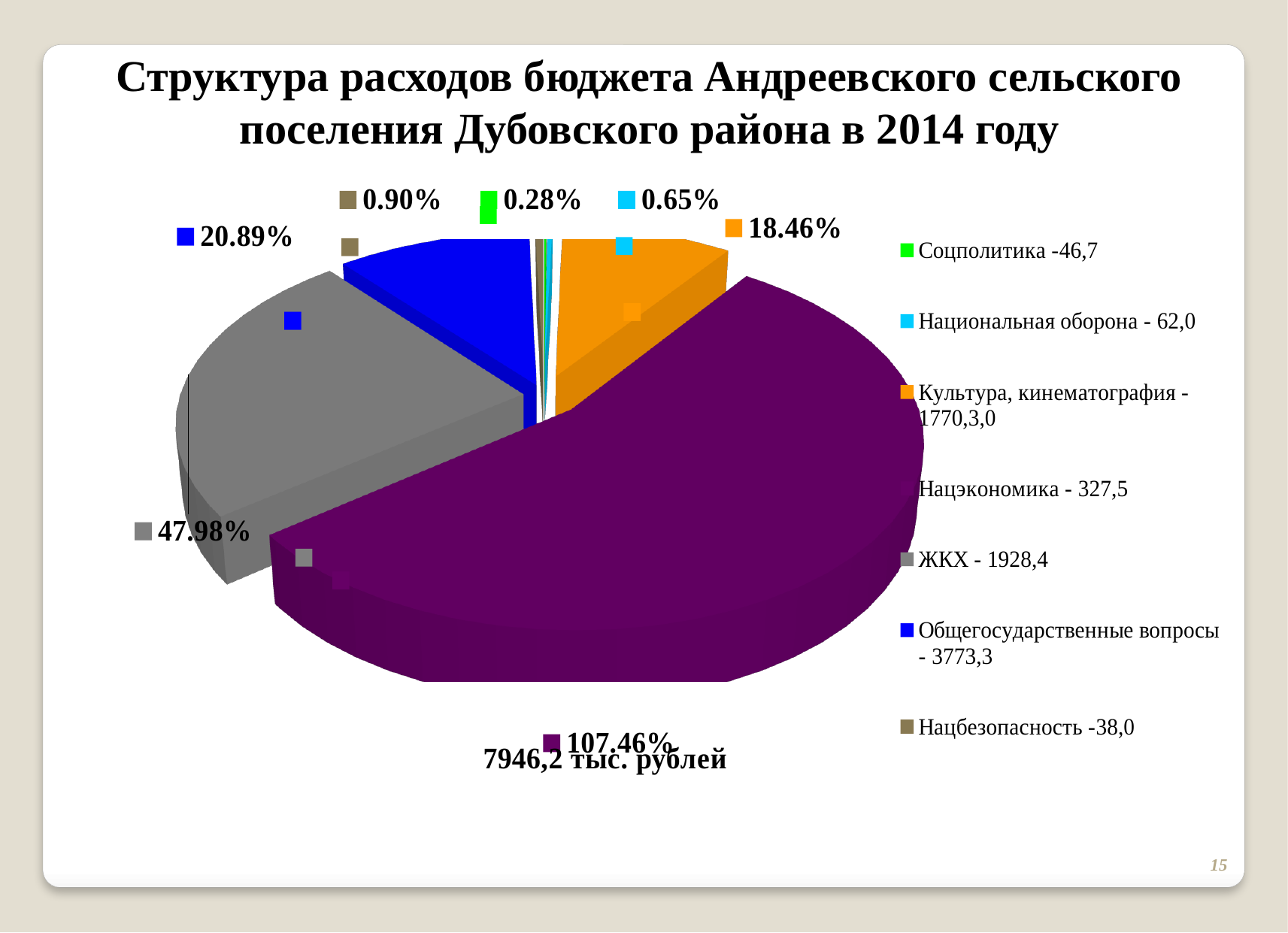
What is the difference between the legend values for Общегосударственные вопросы and ЖКХ? 1844,9 Which has the larger value in the legend, Культура, кинематография or ЖКХ? ЖКХ What percentage label is shown on the gray slice (ЖКХ)? 47.98% What total amount is printed below the chart? 7946,2 тыс. рублей What percentage label is shown on the orange slice (Культура, кинематография)? 18.46% How many entries does the legend list? 7 What is the smallest percentage label shown on the chart? 0.28% What value is given for ЖКХ in the legend? 1928,4 What kind of chart is shown on the slide? pie chart What is the largest percentage label shown on the chart? 107.46% What value is given for Общегосударственные вопросы in the legend? 3773,3 What value is given for Национальная оборона in the legend? 62,0